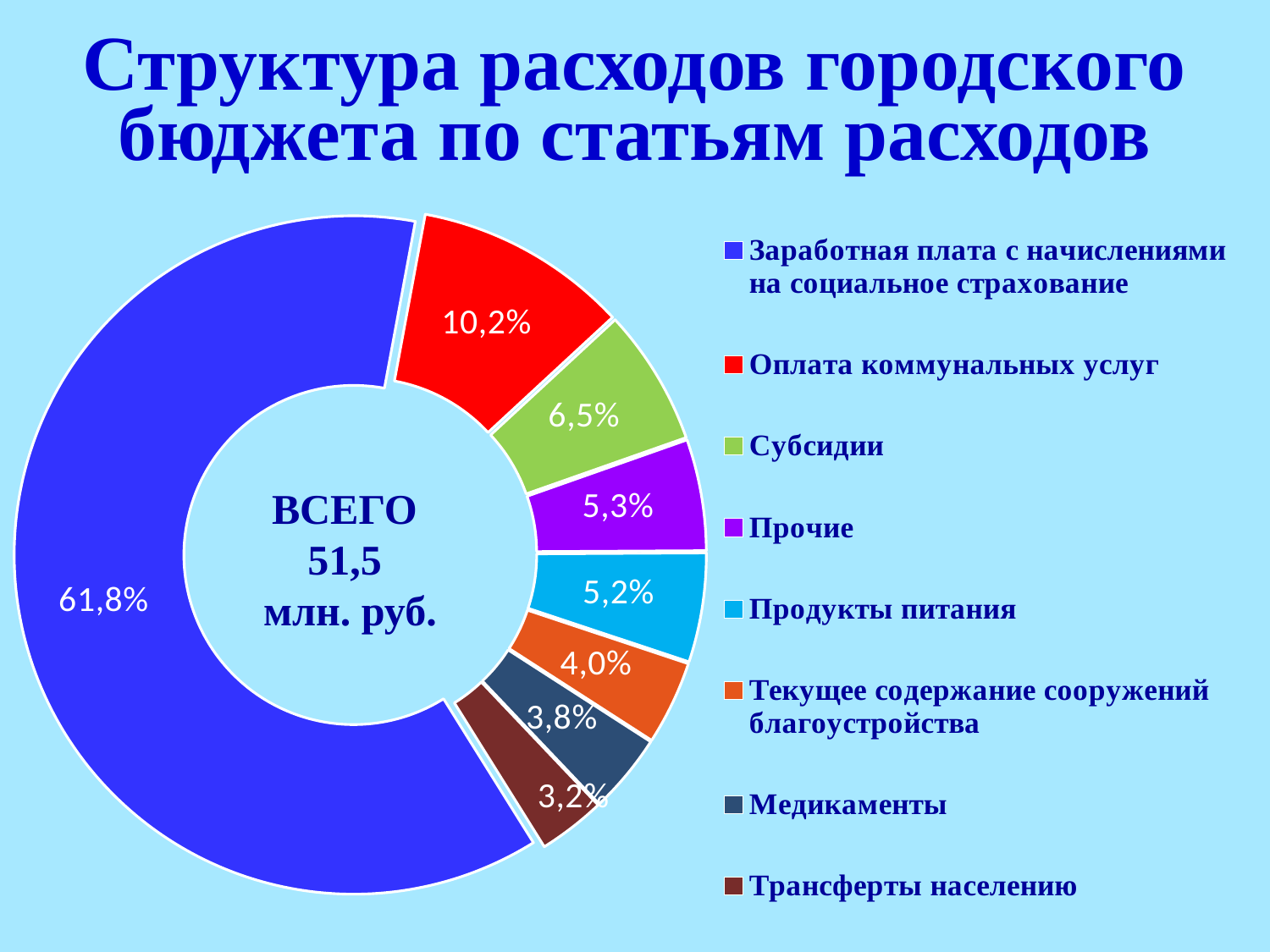
Which is larger: the share for Прочие or the share for Продукты питания? Прочие What total amount is written in the centre of the chart? 51,5 млн. руб. What is the share for Субсидии? 6,5% Which expenditure item has the smallest share? Трансферты населению What percentage is shown for Оплата коммунальных услуг? 10,2% What colour is the segment for Текущее содержание сооружений благоустройства? Orange How many expenditure categories are shown in the chart? 8 What is the difference in percentage points between Оплата коммунальных услуг and Субсидии? 3,7 Which expenditure item has the largest share of the budget? Заработная плата с начислениями на социальное страхование What share of the city budget expenditure goes to Заработная плата с начислениями на социальное страхование? 61,8% What kind of chart is shown on the slide? Doughnut (pie) chart What percentage does the chart show for Медикаменты? 3,8%